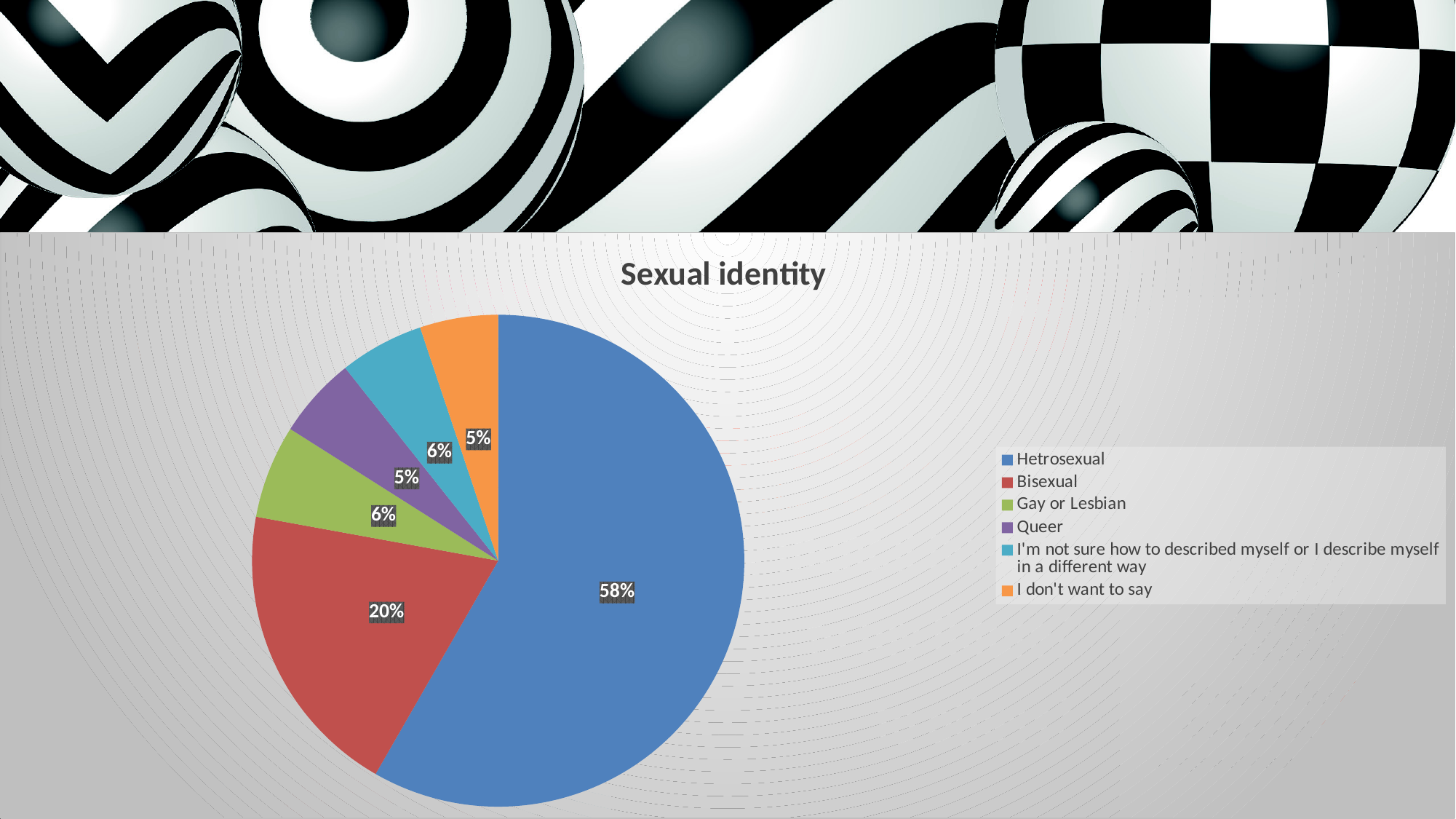
What percentage of the pie is Hetrosexual? 58% What percentage of the pie is 'I don't want to say'? 5% Which is larger, the Bisexual slice or the Gay or Lesbian slice? Bisexual What type of chart is shown on the slide? pie chart What colour is the Hetrosexual slice? blue What percentage of the pie is Queer? 5% What is the title of the chart? Sexual identity What percentage of the pie is Gay or Lesbian? 6% What is the difference in percentage points between the Hetrosexual and Bisexual slices? 38 What percentage of the pie is Bisexual? 20% Which category has the largest share of the pie? Hetrosexual How many categories does the legend list? 6